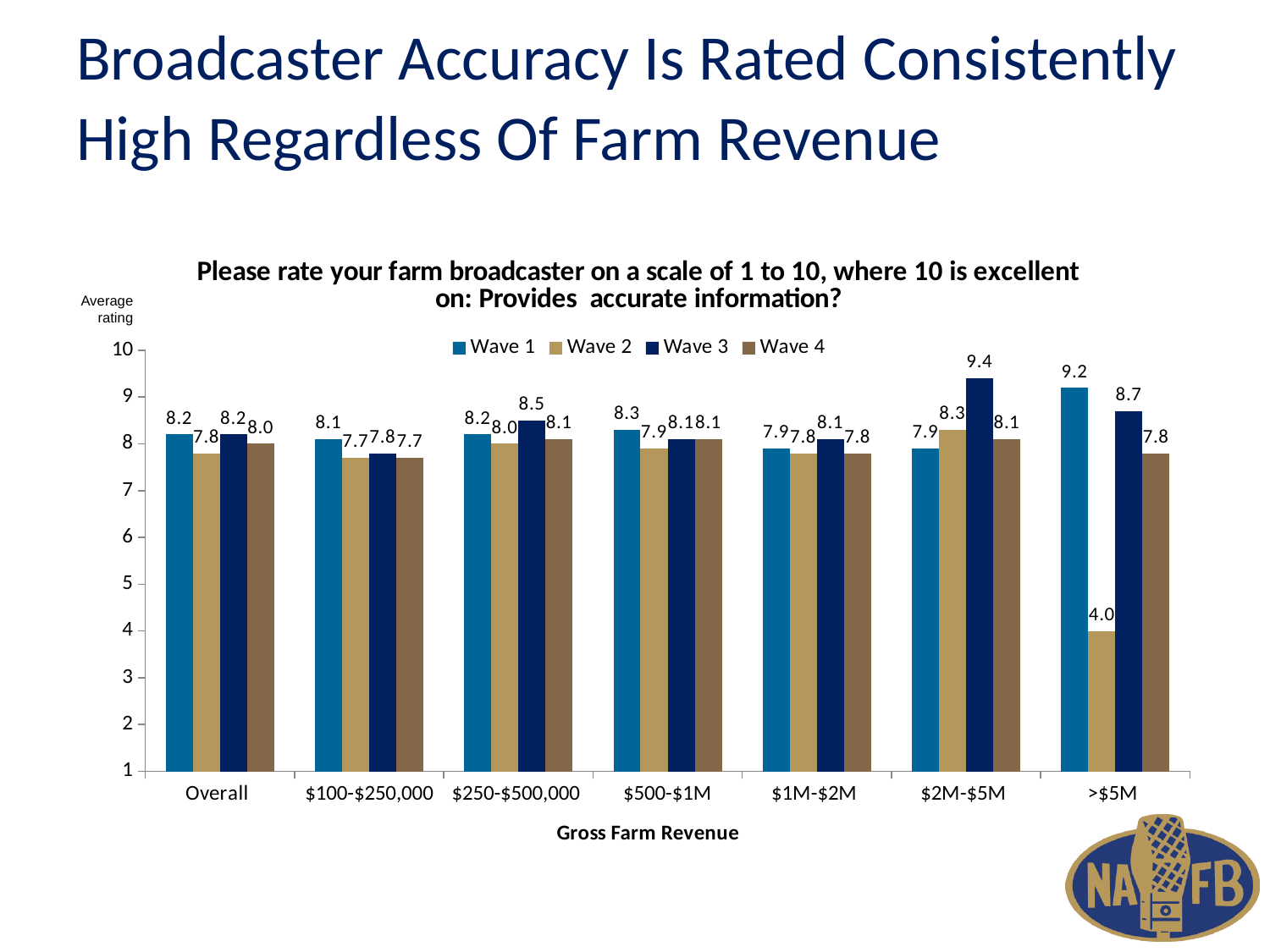
How many series does the legend list? 4 What is the difference between the Wave 1 and Wave 2 ratings for the >$5M group? 5.2 What is the Wave 4 rating for the $250-$500,000 group? 8.1 What kind of chart is shown on the slide? Bar chart Which gross farm revenue group has the highest Wave 3 rating? $2M-$5M What is the Wave 3 rating for the $2M-$5M gross farm revenue group? 9.4 Which gross farm revenue group has the lowest Wave 2 rating? >$5M How many gross farm revenue categories are shown on the x axis? 7 Which is larger for the $2M-$5M group: the Wave 1 rating or the Wave 3 rating? Wave 3 What is the Wave 1 rating for the Overall category? 8.2 What is the Wave 2 rating for the >$5M gross farm revenue group? 4.0 What is the label of the x axis? Gross Farm Revenue